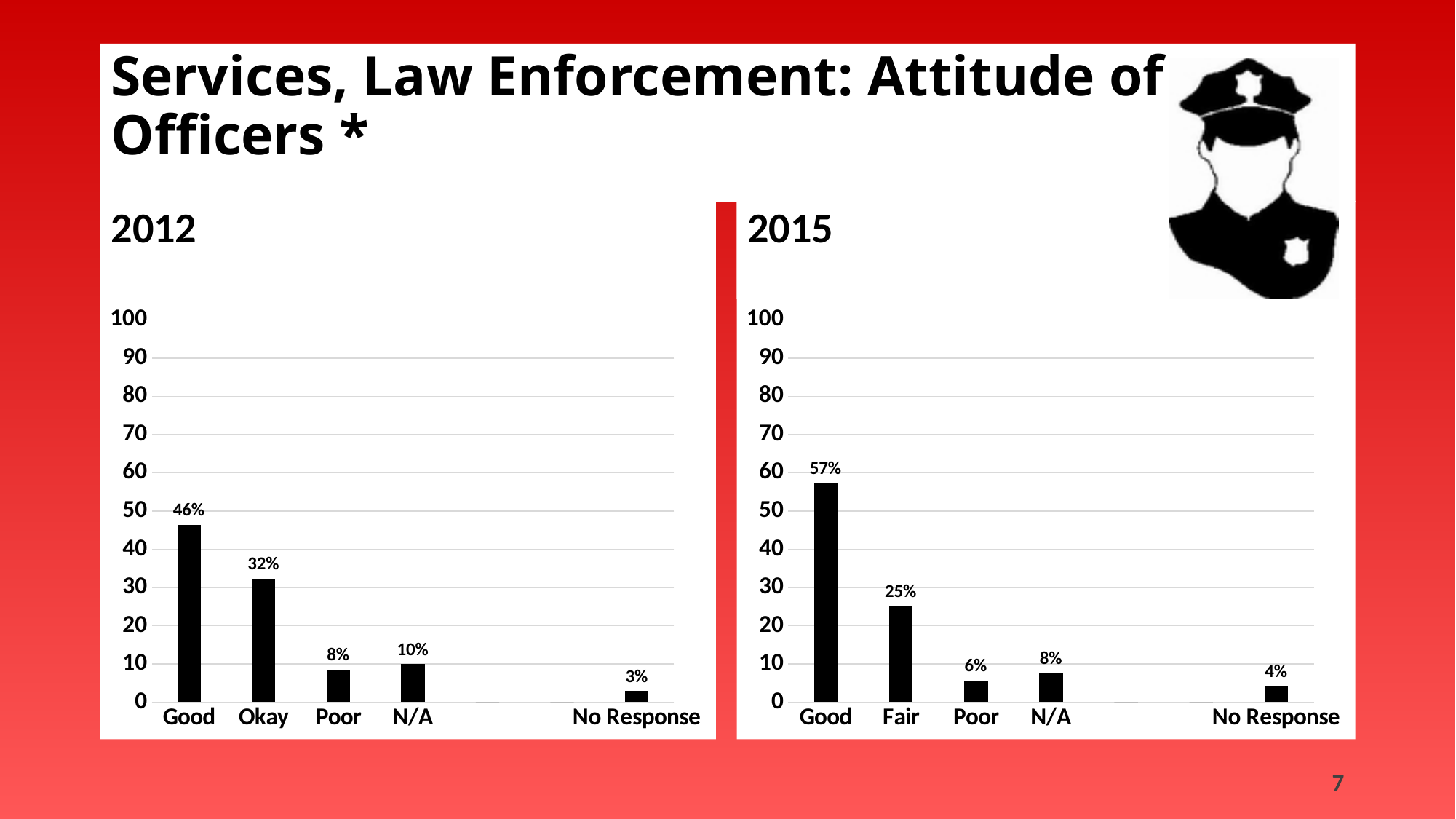
In the 2012 chart, what is the value for Good? 46% What kind of chart is the 2012 chart? bar chart Which is larger: Good in the 2012 chart or Good in the 2015 chart? Good in the 2015 chart How many categories are shown in the 2015 chart? 5 In the 2012 chart, what is the value for No Response? 3% In the 2015 chart, what is the value for Fair? 25% In the 2015 chart, what is the difference between Good and Fair? 32% In the 2012 chart, what is the difference between Okay and Poor? 24% In the 2012 chart, is the value for Okay greater or less than 40? less In the 2015 chart, which category has the highest value? Good In the 2015 chart, what is the value for N/A? 8% In the 2012 chart, which category has the lowest value? No Response